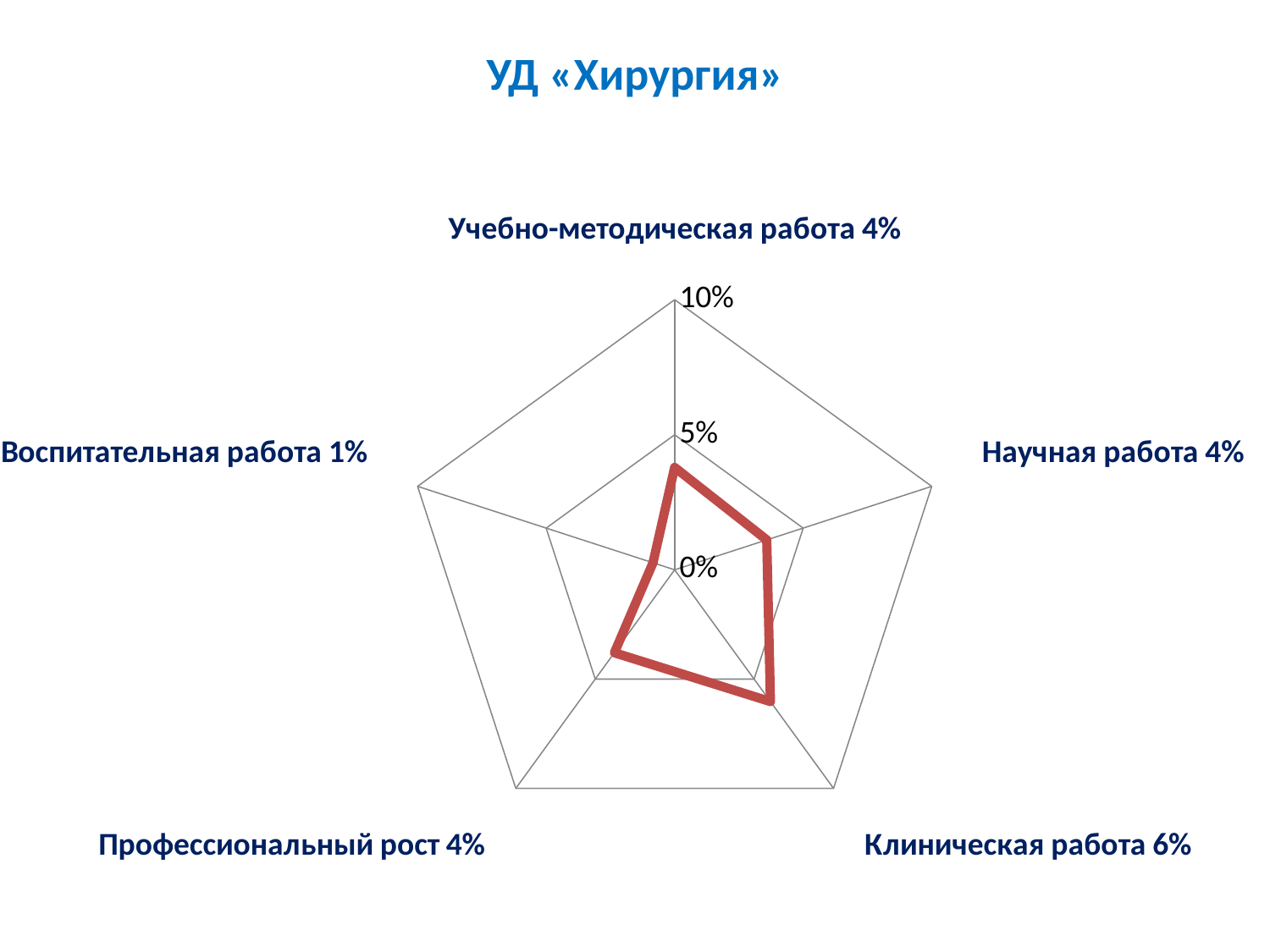
What is the title of the chart? УД «Хирургия» Which category has the lowest value? Воспитательная работа What is the value for Клиническая работа? 6% Is the value for Клиническая работа greater or less than 5%? greater How many categories (axes) does the radar chart have? 5 What is the value for Воспитательная работа? 1% What is the difference between the values for Клиническая работа and Воспитательная работа? 5% Which is larger, the value for Клиническая работа or the value for Профессиональный рост? Клиническая работа What is the value for Научная работа? 4% What kind of chart is shown on the slide? radar chart Which category has the highest value? Клиническая работа What is the value for Учебно-методическая работа? 4%